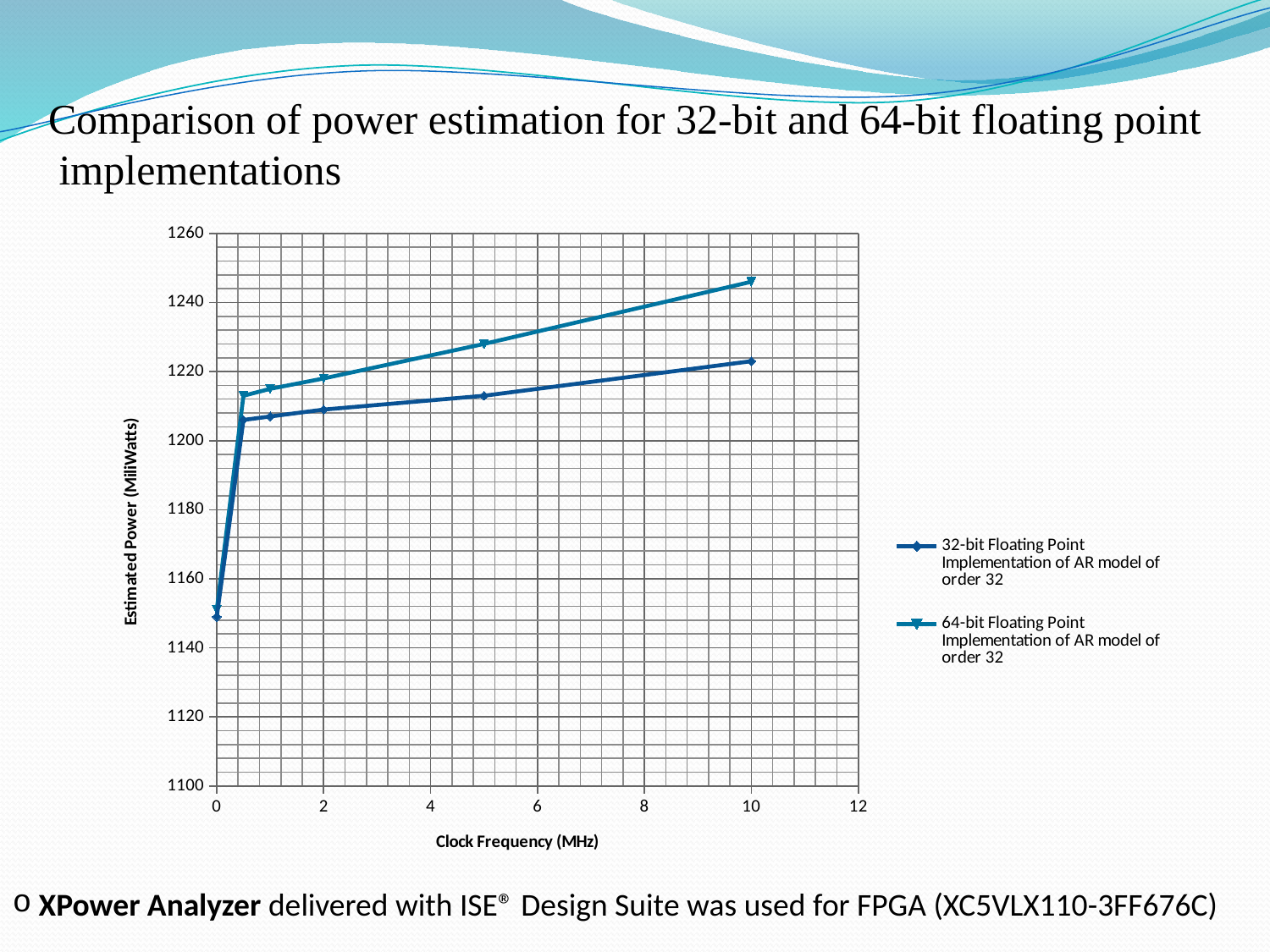
Which series has the higher estimated power at 10 MHz? 64-bit Floating Point Implementation of AR model of order 32 How many series does the legend list? 2 What kind of chart is shown on the slide? line chart Is the estimated power for the 64-bit implementation at 5 MHz greater or less than 1220? greater What is the label of the y axis? Estimated Power (MiliWatts) Is the estimated power for the 64-bit implementation at 10 MHz greater or less than 1240? greater Is the estimated power for the 32-bit implementation at 10 MHz greater or less than 1240? less How many data points are plotted for each series? 6 Does the estimated power for the 64-bit implementation rise or fall as clock frequency increases? rise What is the label of the x axis? Clock Frequency (MHz)